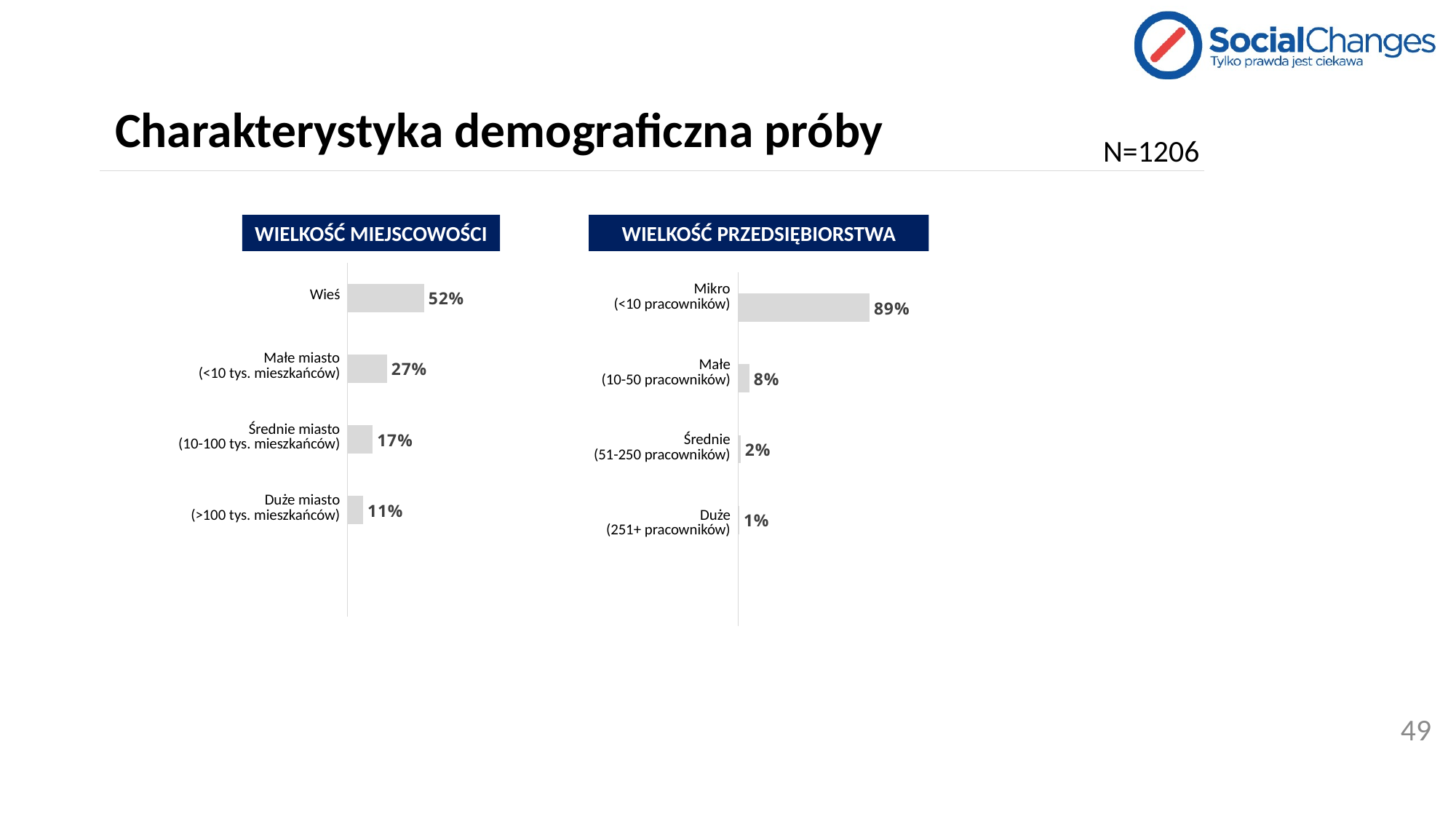
In the WIELKOŚĆ PRZEDSIĘBIORSTWA chart, what is the value for Średnie (51-250 pracowników)? 2% In the WIELKOŚĆ PRZEDSIĘBIORSTWA chart, which category has the lowest value? Duże (251+ pracowników) In the WIELKOŚĆ MIEJSCOWOŚCI chart, what is the difference between Małe miasto and Średnie miasto? 10% In the WIELKOŚĆ PRZEDSIĘBIORSTWA chart, what is the value for Mikro (<10 pracowników)? 89% In the WIELKOŚĆ MIEJSCOWOŚCI chart, what is the value for Duże miasto (>100 tys. mieszkańców)? 11% In the WIELKOŚĆ PRZEDSIĘBIORSTWA chart, which is larger, Małe (10-50 pracowników) or Średnie (51-250 pracowników)? Małe (10-50 pracowników) What sample size (N) is shown on the slide? N=1206 What kind of chart is the WIELKOŚĆ MIEJSCOWOŚCI chart? Bar chart In the WIELKOŚĆ MIEJSCOWOŚCI chart, which category has the highest value? Wieś In the WIELKOŚĆ MIEJSCOWOŚCI chart, what is the value for Wieś? 52% In the WIELKOŚĆ MIEJSCOWOŚCI chart, how many categories are shown? 4 In the WIELKOŚĆ PRZEDSIĘBIORSTWA chart, what is the difference between Mikro and Małe? 81%